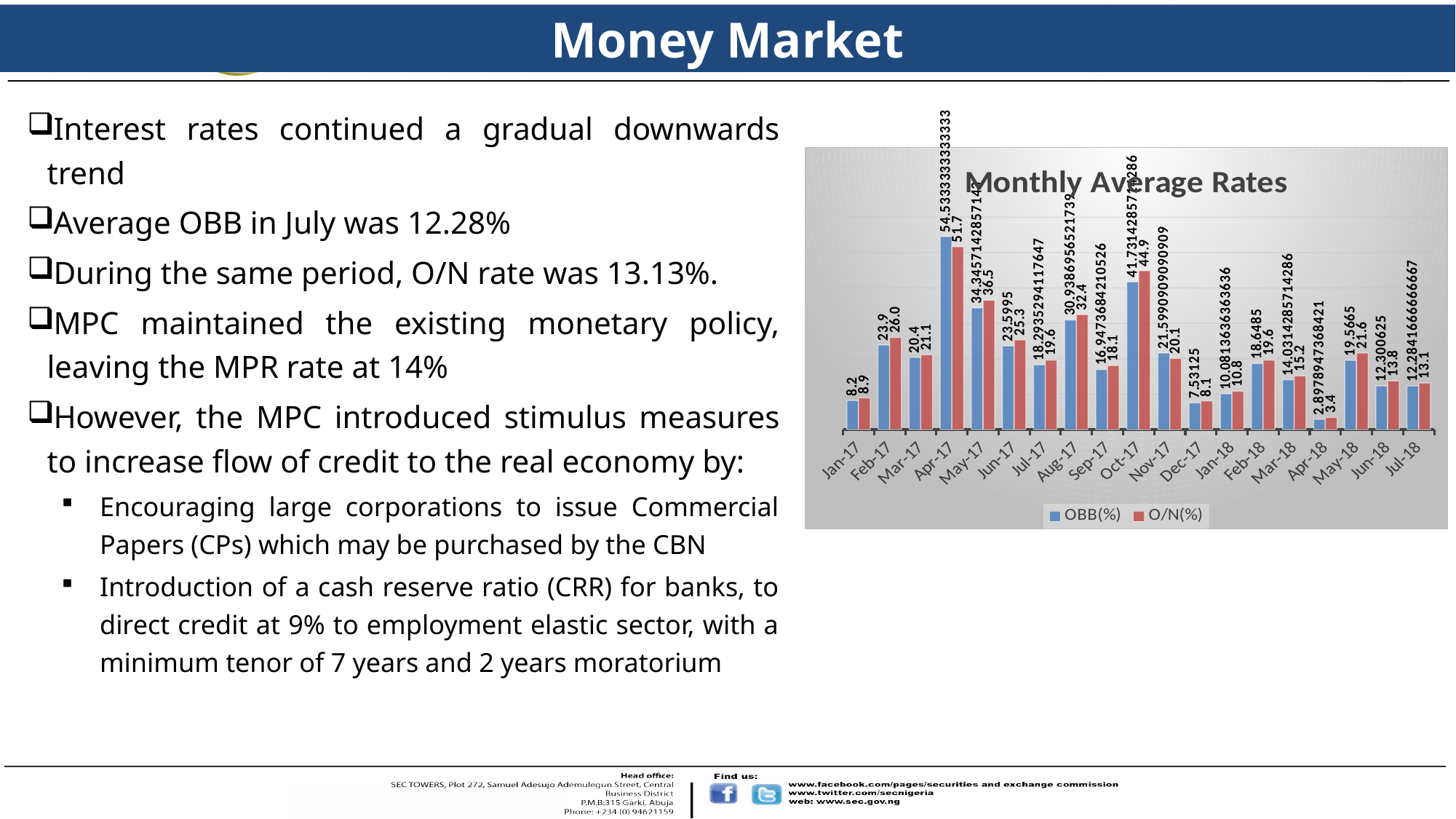
Which month has the highest OBB(%) value in the Monthly Average Rates chart? Apr-17 What is the difference between the O/N(%) values for Apr-17 and Oct-17 in the Monthly Average Rates chart? 6.8 What is the O/N(%) value for Jan-17 in the Monthly Average Rates chart? 8.9 How many months are plotted on the x axis of the Monthly Average Rates chart? 19 In the Monthly Average Rates chart, which is larger for Nov-17: OBB(%) or O/N(%)? OBB(%) What is the OBB(%) value for Dec-17 in the Monthly Average Rates chart? 7.53125 How many series does the legend of the Monthly Average Rates chart list? 2 What is the title of the chart on the slide? Monthly Average Rates In the Monthly Average Rates chart, which is larger for Feb-17: OBB(%) or O/N(%)? O/N(%) Which month has the lowest O/N(%) value in the Monthly Average Rates chart? Apr-18 What is the O/N(%) value for Jul-18 in the Monthly Average Rates chart? 13.1 What kind of chart is shown on the slide? bar chart